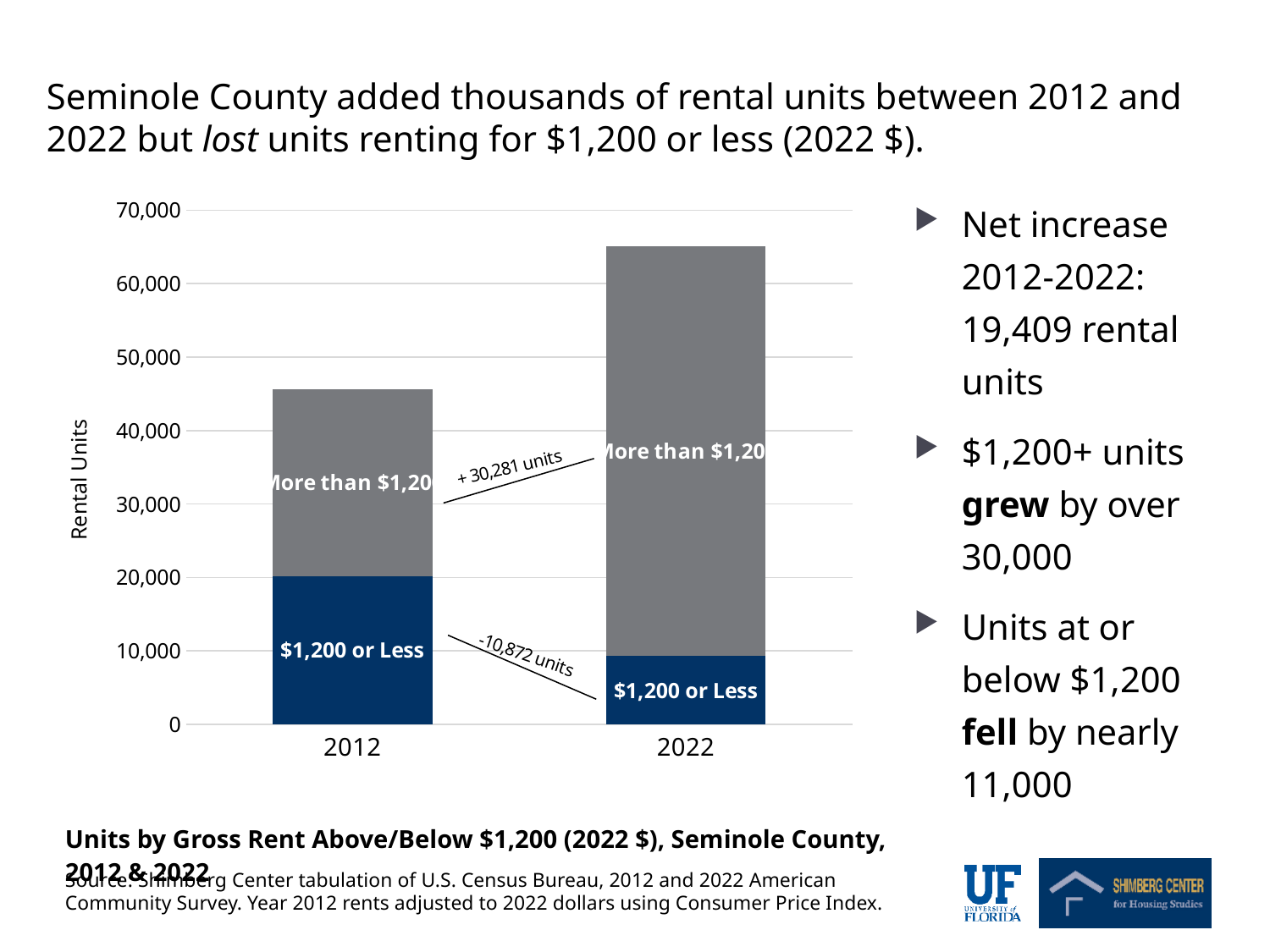
What is the label on the vertical axis of the chart? Rental Units According to the annotation on the chart, by how many units did the '$1,200 or Less' segment change between 2012 and 2022? -10,872 units What kind of chart is shown on the slide? Stacked bar chart Which year has the larger '$1,200 or Less' segment, 2012 or 2022? 2012 Which year has the taller total bar, 2012 or 2022? 2022 Is the total height of the 2022 bar greater or less than 60,000? greater How many rent segments make up each stacked bar in the chart? 2 Does the '$1,200 or Less' segment rise or fall from 2012 to 2022? fall Is the total height of the 2012 bar greater or less than 50,000? less According to the annotation on the chart, by how many units did the 'More than $1,200' segment change between 2012 and 2022? +30,281 units How many years (categories) are shown on the x axis of the chart? 2